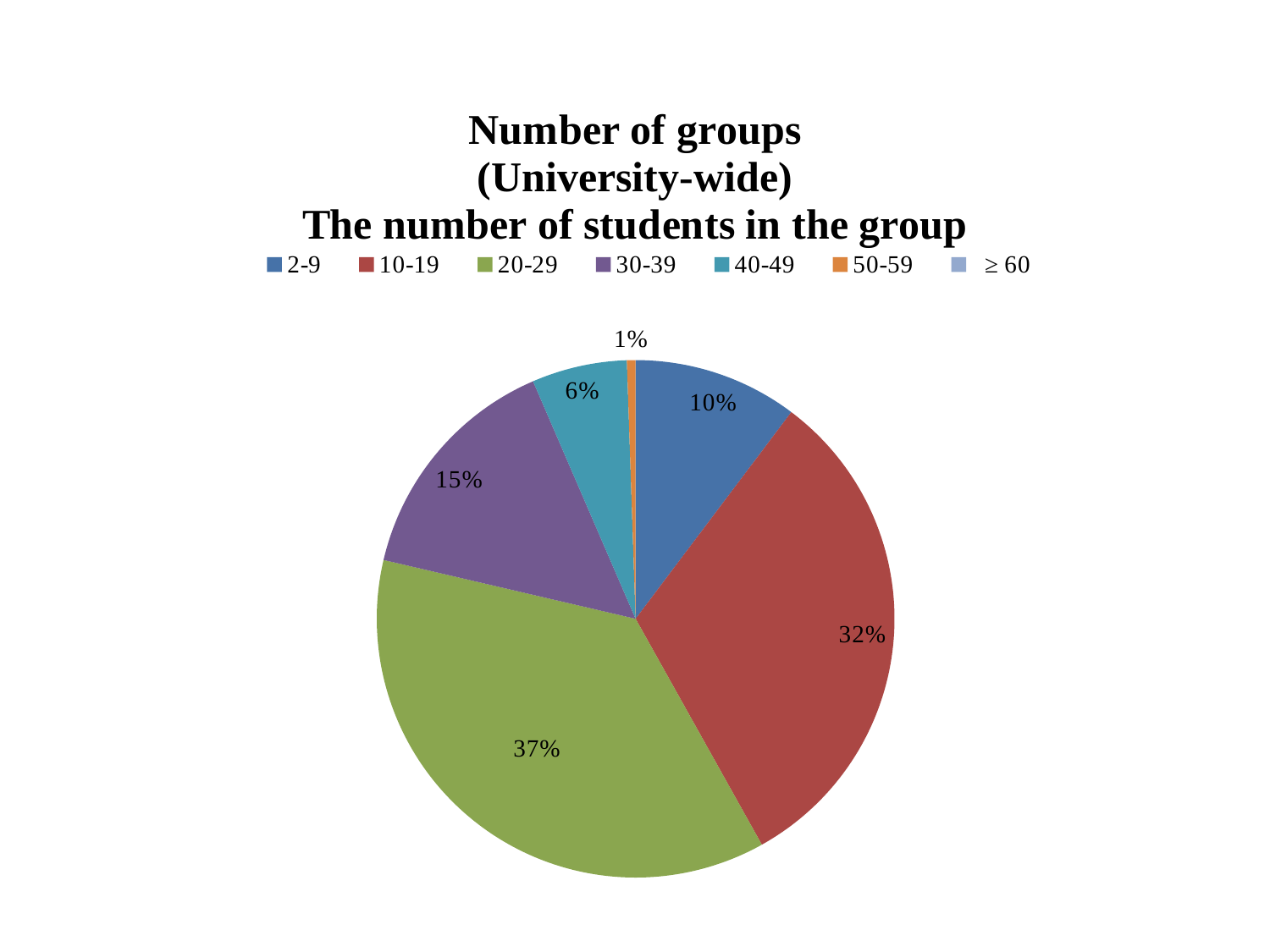
How many percentage points larger is the 20-29 slice than the 10-19 slice? 5 What colour is the 20-29 slice? green What share of groups have 20-29 students? 37% What kind of chart is shown on the slide? pie chart What share of groups have 30-39 students? 15% What share of groups have 10-19 students? 32% What share of groups have 2-9 students? 10% What share of groups have 50-59 students? 1% Which slice is larger, 30-39 or 40-49? 30-39 Which group-size category has the largest share of the pie? 20-29 How many categories does the legend list? 7 What share of groups have 40-49 students? 6%